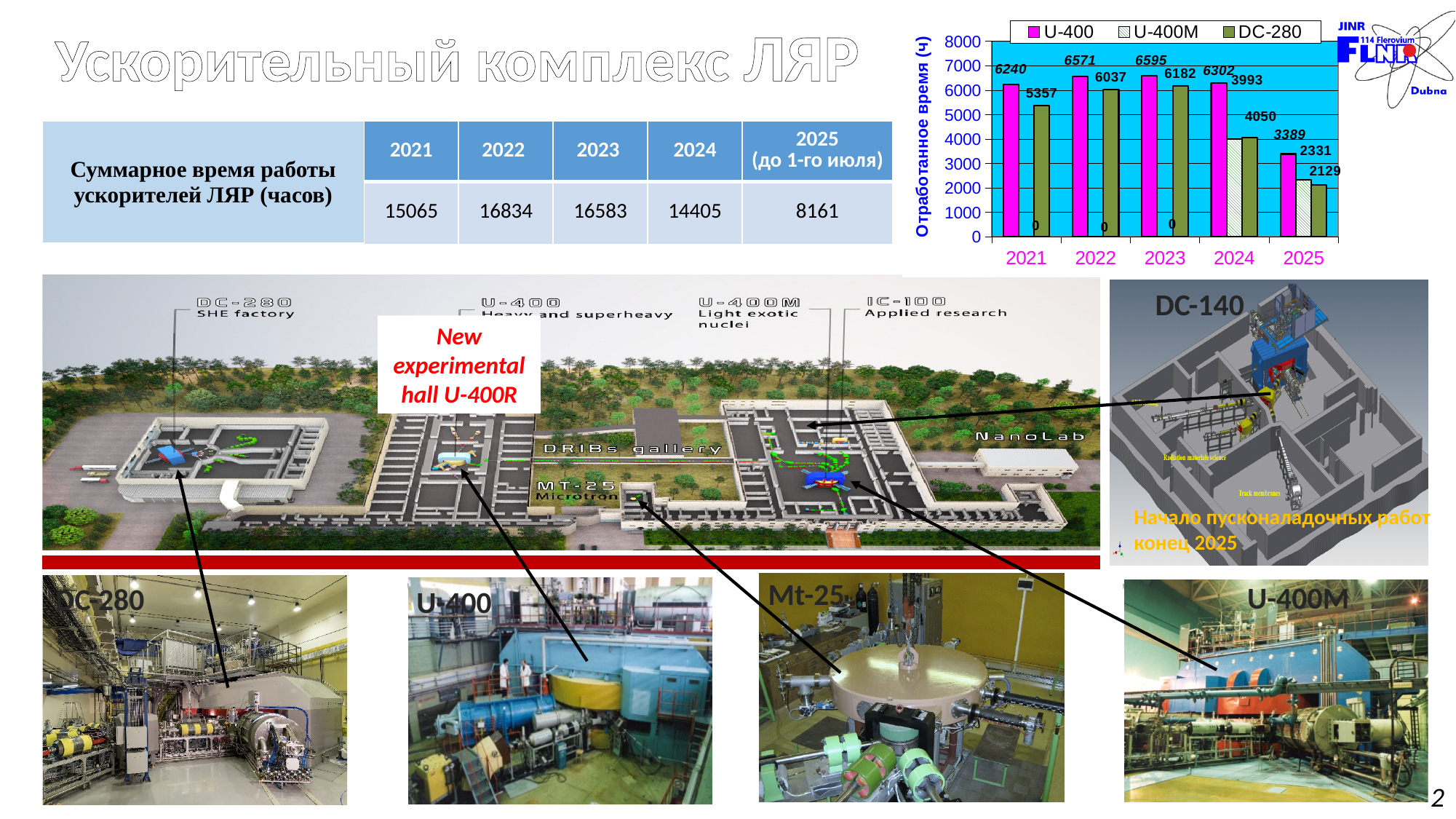
What is the label of the vertical axis of the bar chart? Отработанное время (ч) In which year does U-400 have its highest value in the bar chart? 2023 What type of chart is shown in the top right of the slide? bar chart In 2024, which series has the larger value in the bar chart, U-400M or DC-280? DC-280 How many years are shown on the x axis of the bar chart? 5 What is the value for DC-280 in 2021 in the bar chart? 5357 What is the difference between the U-400 and DC-280 values in 2022 in the bar chart? 534 How many series does the legend of the bar chart list? 3 What is the value for U-400 in 2023 in the bar chart? 6595 In which year does DC-280 have its lowest value in the bar chart? 2025 Does the value for U-400 in 2025 rise or fall compared with 2024 in the bar chart? fall What is the value for U-400M in 2024 in the bar chart? 3993